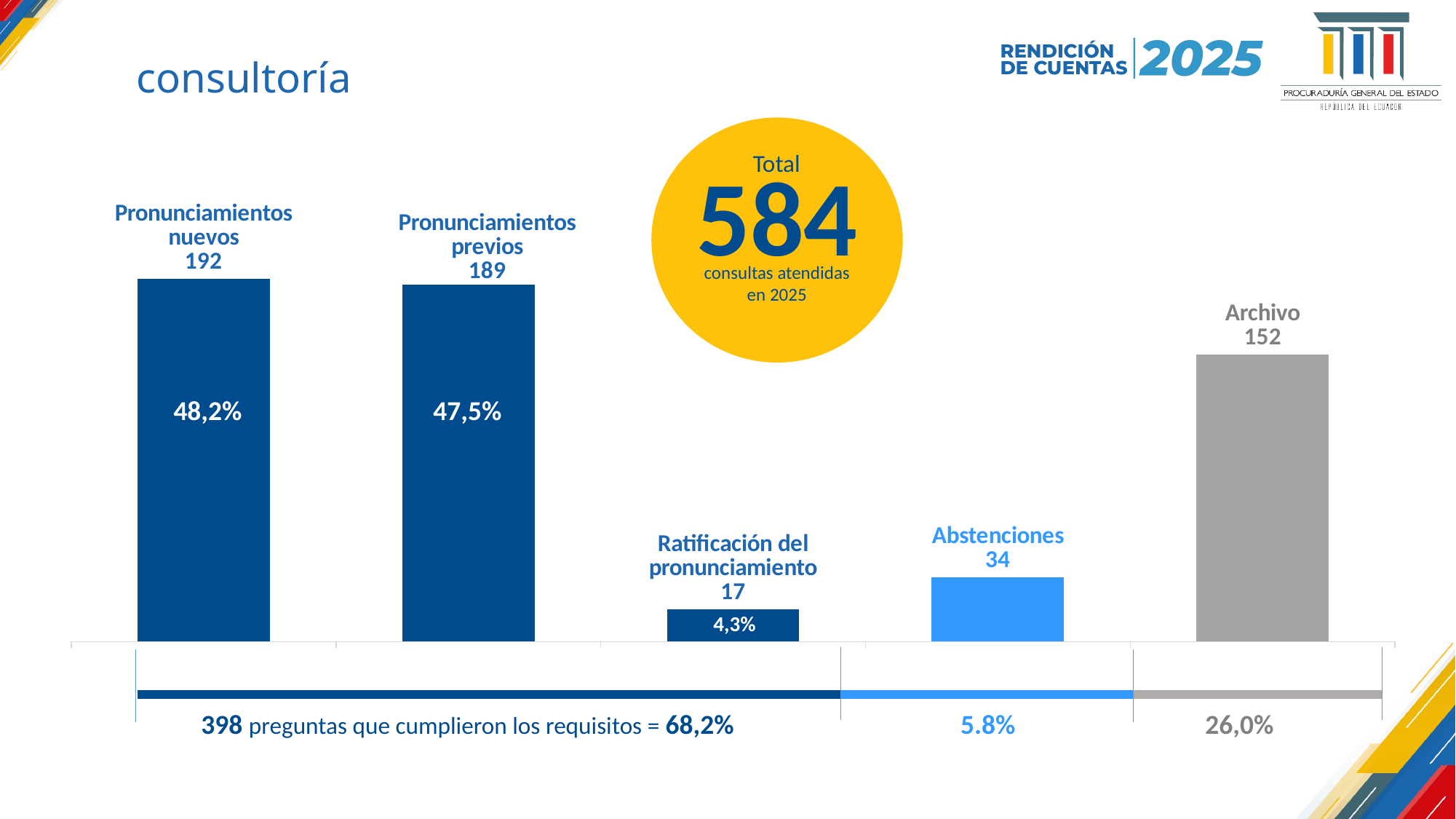
What is the value for Archivo? 152 Which category has the lowest value? Ratificación del pronunciamiento What total number of consultas atendidas en 2025 is shown in the yellow circle? 584 What is the value for Pronunciamientos nuevos? 192 What is the difference between Archivo and Abstenciones? 118 What percentage is shown inside the Pronunciamientos previos bar? 47,5% What kind of chart is shown on the slide? Bar chart Which category has the highest value? Pronunciamientos nuevos What is the value for Abstenciones? 34 How many categories are shown in the chart? 5 Which is larger, Archivo or Abstenciones? Archivo What is the difference between Pronunciamientos nuevos and Pronunciamientos previos? 3